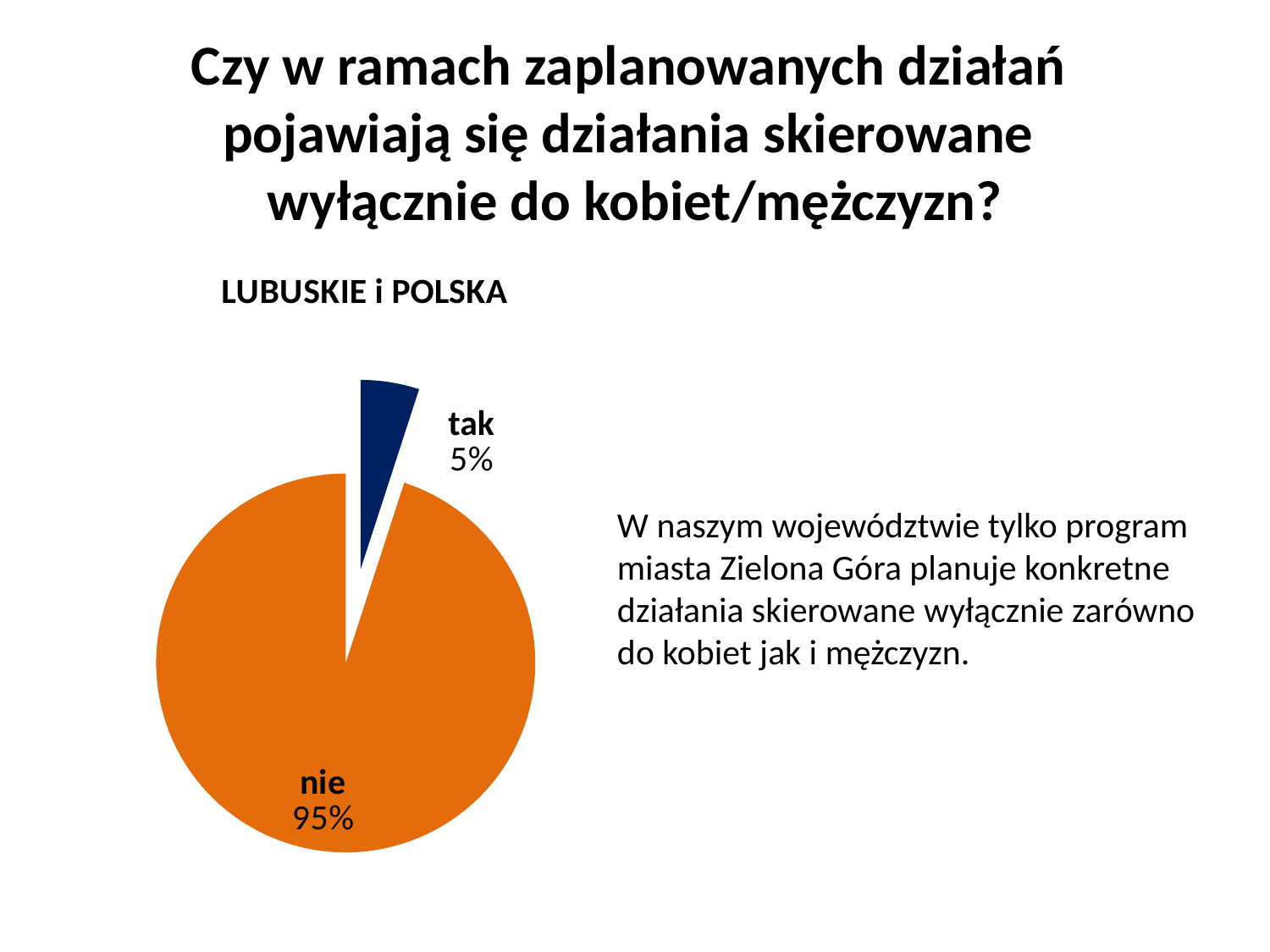
What is the combined share of the "tak" and "nie" slices? 100% Which slice of the pie is the largest? nie What kind of chart is shown on the slide? pie chart What share of the pie does the "tak" slice represent? 5% What is the label above the pie chart? LUBUSKIE i POLSKA What is the difference in percentage points between the "nie" and "tak" slices? 90 What colour is the "tak" slice? dark blue Which slice of the pie is the smallest? tak Which is larger, the "tak" slice or the "nie" slice? nie How many slices does the pie chart have? 2 What share of the pie does the "nie" slice represent? 95%